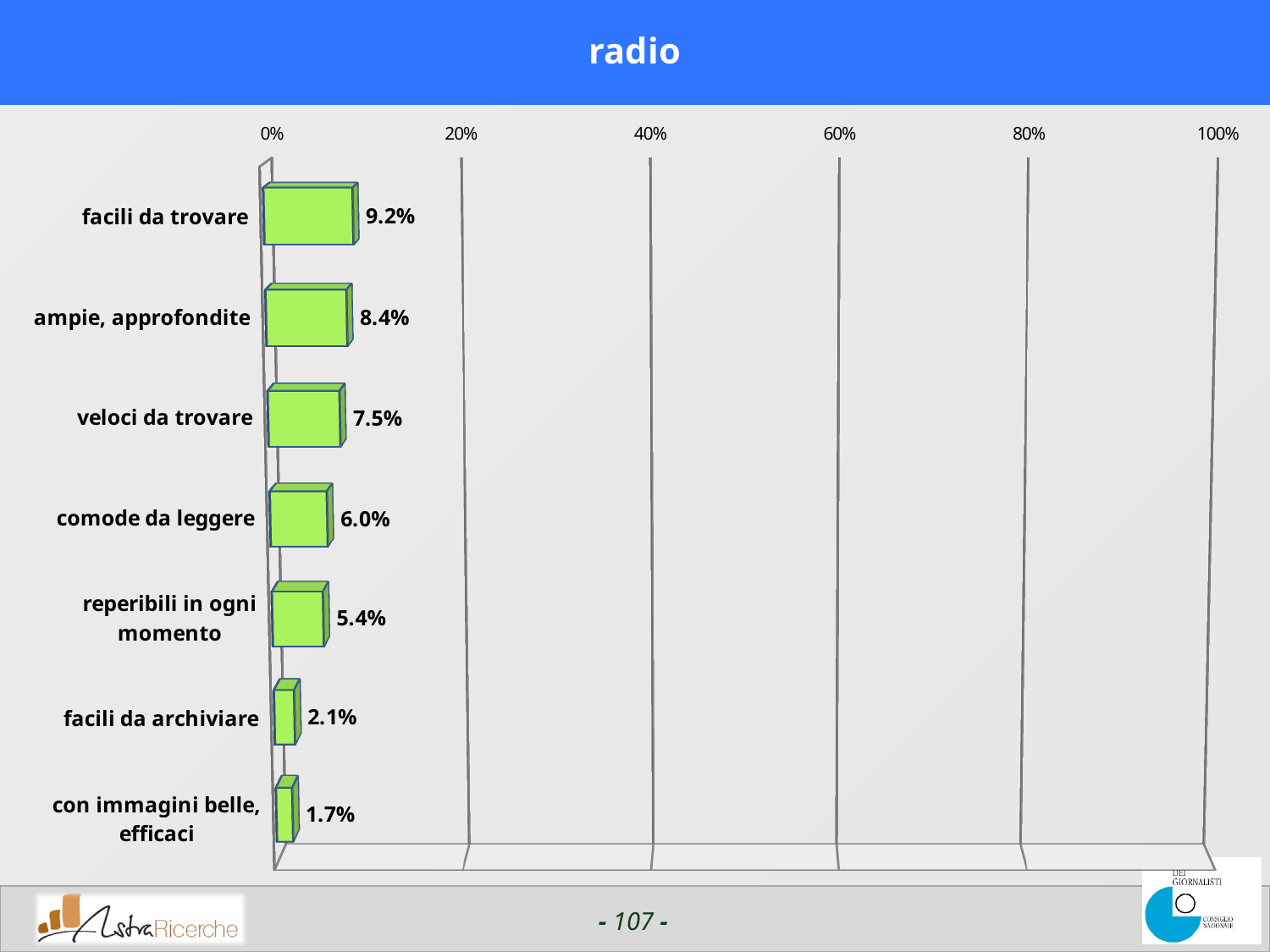
Which category has the highest value? facili da trovare Which is larger, the value for "veloci da trovare" or the value for "comode da leggere"? veloci da trovare Which category has the lowest value? con immagini belle, efficaci What is the difference between the values for "facili da trovare" and "ampie, approfondite"? 0.8% What is the difference between the values for "veloci da trovare" and "facili da archiviare"? 5.4% What is the value for "con immagini belle, efficaci"? 1.7% How many categories are shown in the chart? 7 What is the value for "facili da trovare"? 9.2% What is the value for "reperibili in ogni momento"? 5.4% What is the value for "comode da leggere"? 6.0% Is the value for "facili da trovare" greater or less than 20%? less What kind of chart is shown on the slide? bar chart